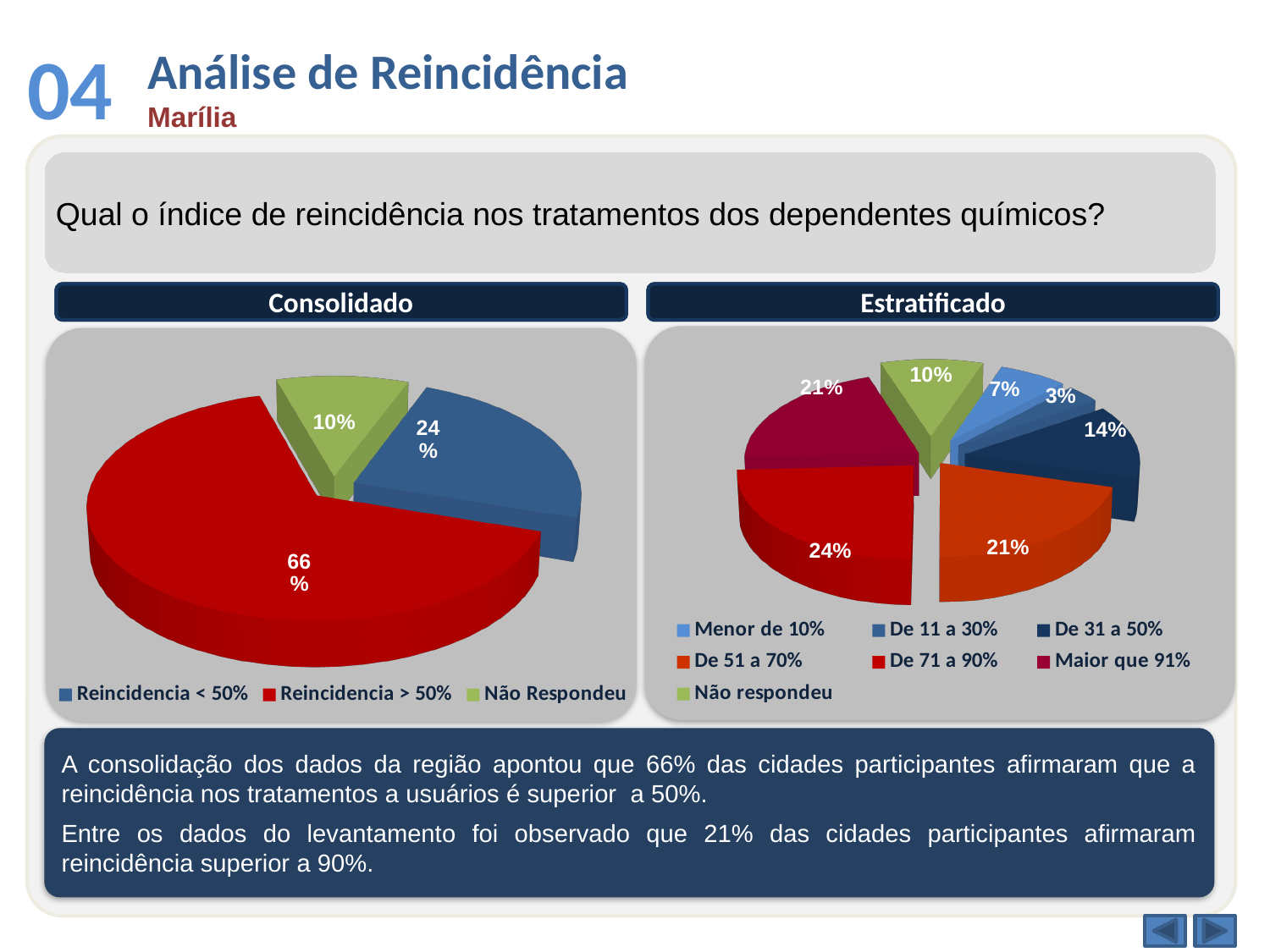
In the Consolidado chart, what is the value for Reincidencia > 50%? 66% In the Estratificado chart, which is larger: De 31 a 50% or Menor de 10%? De 31 a 50% In the Consolidado chart, what is the difference between Reincidencia > 50% and Reincidencia < 50%? 42% What kind of chart is the Consolidado chart? Pie chart In the Estratificado chart, which category has the largest slice? De 71 a 90% How many categories does the legend of the Consolidado chart list? 3 How many categories does the legend of the Estratificado chart list? 7 In the Estratificado chart, what is the value for De 71 a 90%? 24% In the Consolidado chart, which category has the smallest slice? Não Respondeu In the Consolidado chart, what is the value for Reincidencia < 50%? 24% In the Estratificado chart, what is the value for Maior que 91%? 21% In the Estratificado chart, what is the value for De 11 a 30%? 3%